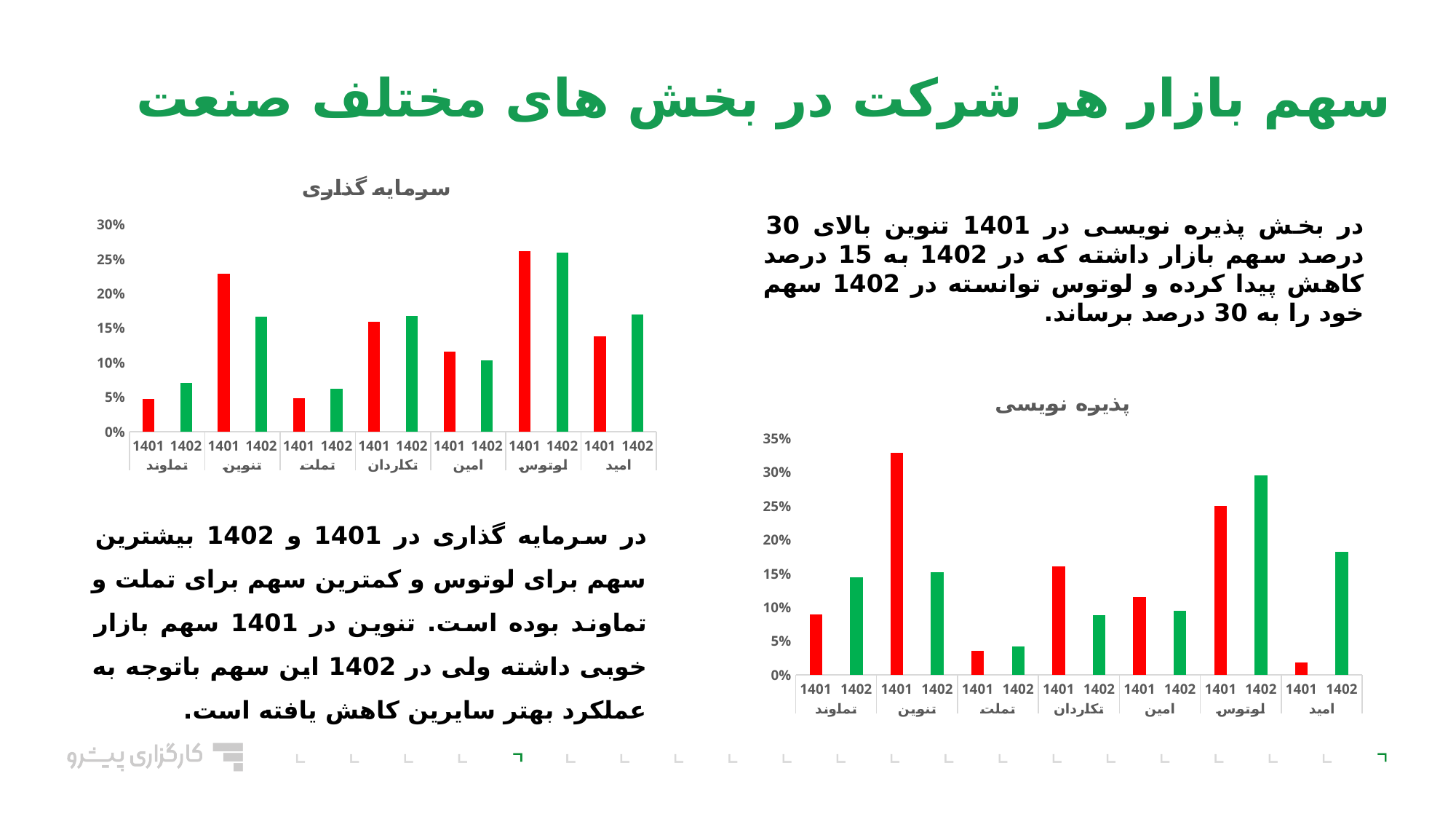
What is the title of the chart on the right side of the slide? پذیره نویسی How many companies (categories) are shown on the x axis of the "پذیره نویسی" chart? 7 In the "پذیره نویسی" chart, is the 1402 value for امید greater or less than 15%? greater In the "سرمایه گذاری" chart, which company has the tallest bar for 1401? لوتوس In the "سرمایه گذاری" chart, which is larger for تنوین: the 1401 bar or the 1402 bar? 1401 In the "پذیره نویسی" chart, is the 1401 value for تنوین greater or less than 30%? greater In the "پذیره نویسی" chart, which company has the shortest bar for 1401? امید What kind of chart is the "سرمایه گذاری" chart on the left of the slide? bar chart In the "سرمایه گذاری" chart, is the 1401 value for تنوین greater or less than 20%? greater In the "پذیره نویسی" chart, which is larger for امید: the 1401 bar or the 1402 bar? 1402 In the "پذیره نویسی" chart, which company has the tallest bar for 1401? تنوین